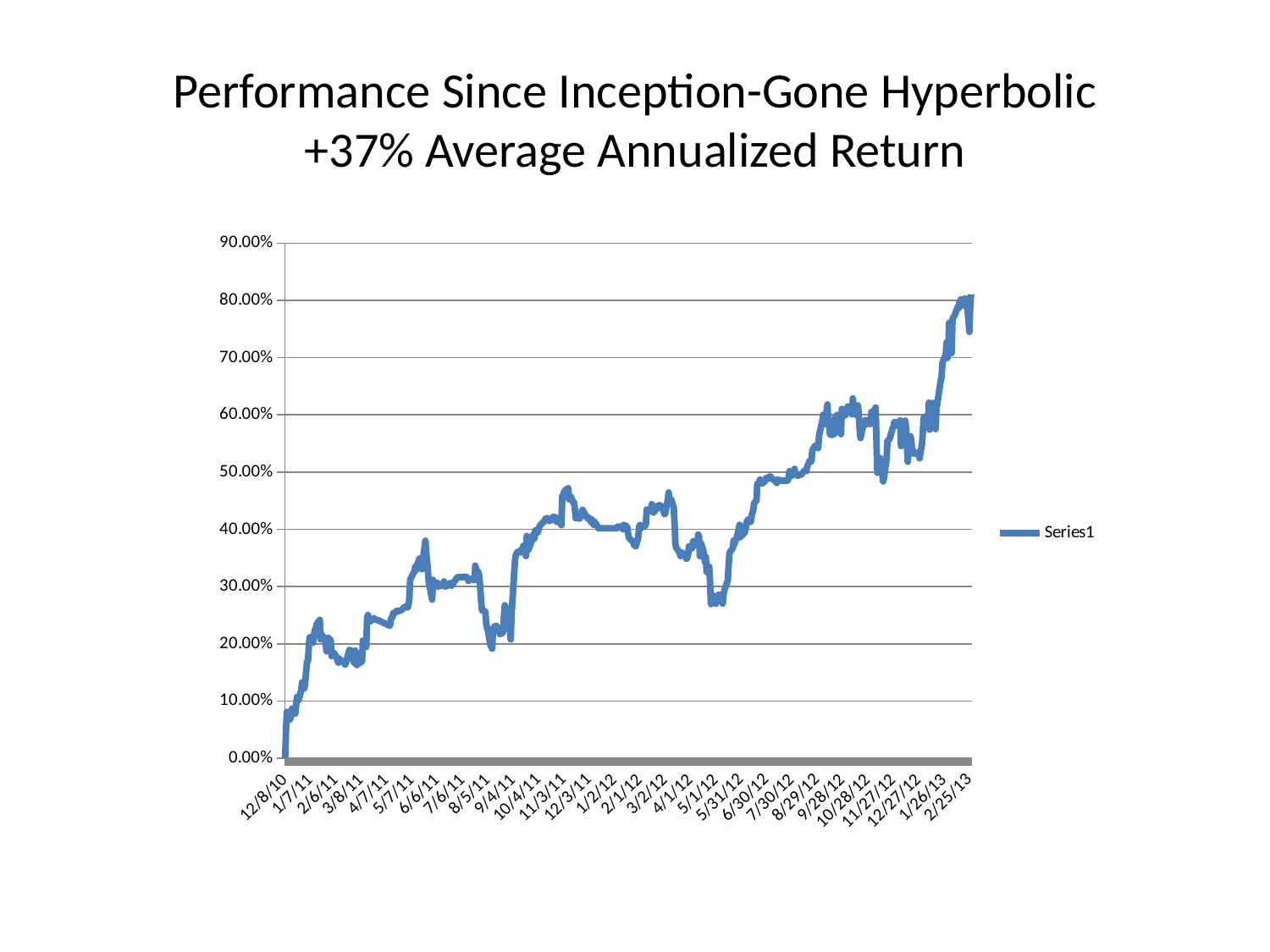
Is the value around 11/3/11 greater or less than 40%? greater What kind of chart is shown on the slide? line chart Overall, do the values rise or fall from 12/8/10 to 2/25/13? rise How many series does the legend list? 1 Is the highest point reached by the series greater or less than 70%? greater What is the name of the series shown in the legend? Series1 What is the title of the slide containing the chart? Performance Since Inception-Gone Hyperbolic +37% Average Annualized Return Which is larger, the value at 2/25/13 or the value at 12/8/10? 2/25/13 Is the value around 5/1/12 greater or less than 30%? less What is the value of the series at the first date, 12/8/10? 0.00%